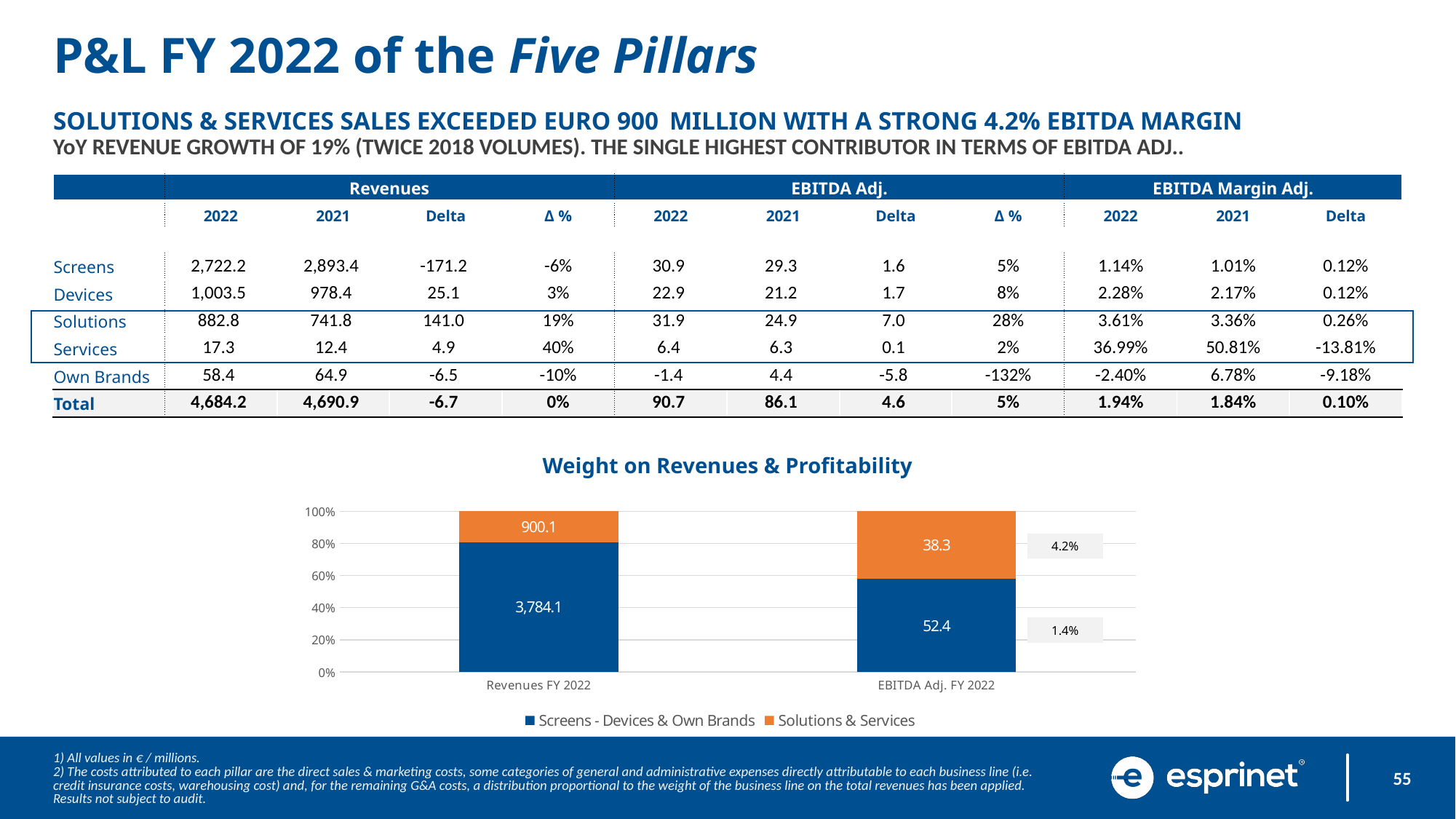
In the 'Weight on Revenues & Profitability' chart, is the share of Screens - Devices & Own Brands in the Revenues FY 2022 bar greater or less than 60%? greater In the 'Weight on Revenues & Profitability' chart, what is the value labelled for Solutions & Services in the EBITDA Adj. FY 2022 bar? 38.3 How many bars (categories) are shown on the x axis of the 'Weight on Revenues & Profitability' chart? 2 What type of chart is shown under the title 'Weight on Revenues & Profitability'? Stacked bar chart In the 'Weight on Revenues & Profitability' chart, what is the value labelled for Solutions & Services in the Revenues FY 2022 bar? 900.1 In the 'Weight on Revenues & Profitability' chart, what is the value labelled for Screens - Devices & Own Brands in the Revenues FY 2022 bar? 3,784.1 In the 'Weight on Revenues & Profitability' chart, which colour represents the Solutions & Services series? Orange In the 'Weight on Revenues & Profitability' chart, what is the difference between the Screens - Devices & Own Brands value and the Solutions & Services value in the EBITDA Adj. FY 2022 bar? 14.1 In the 'Weight on Revenues & Profitability' chart, what is the total of the two labelled values in the Revenues FY 2022 bar? 4,684.2 How many series does the legend of the 'Weight on Revenues & Profitability' chart list? 2 In the 'Weight on Revenues & Profitability' chart, what is the value labelled for Screens - Devices & Own Brands in the EBITDA Adj. FY 2022 bar? 52.4 In the 'Weight on Revenues & Profitability' chart, what is the total of the two labelled values in the EBITDA Adj. FY 2022 bar? 90.7